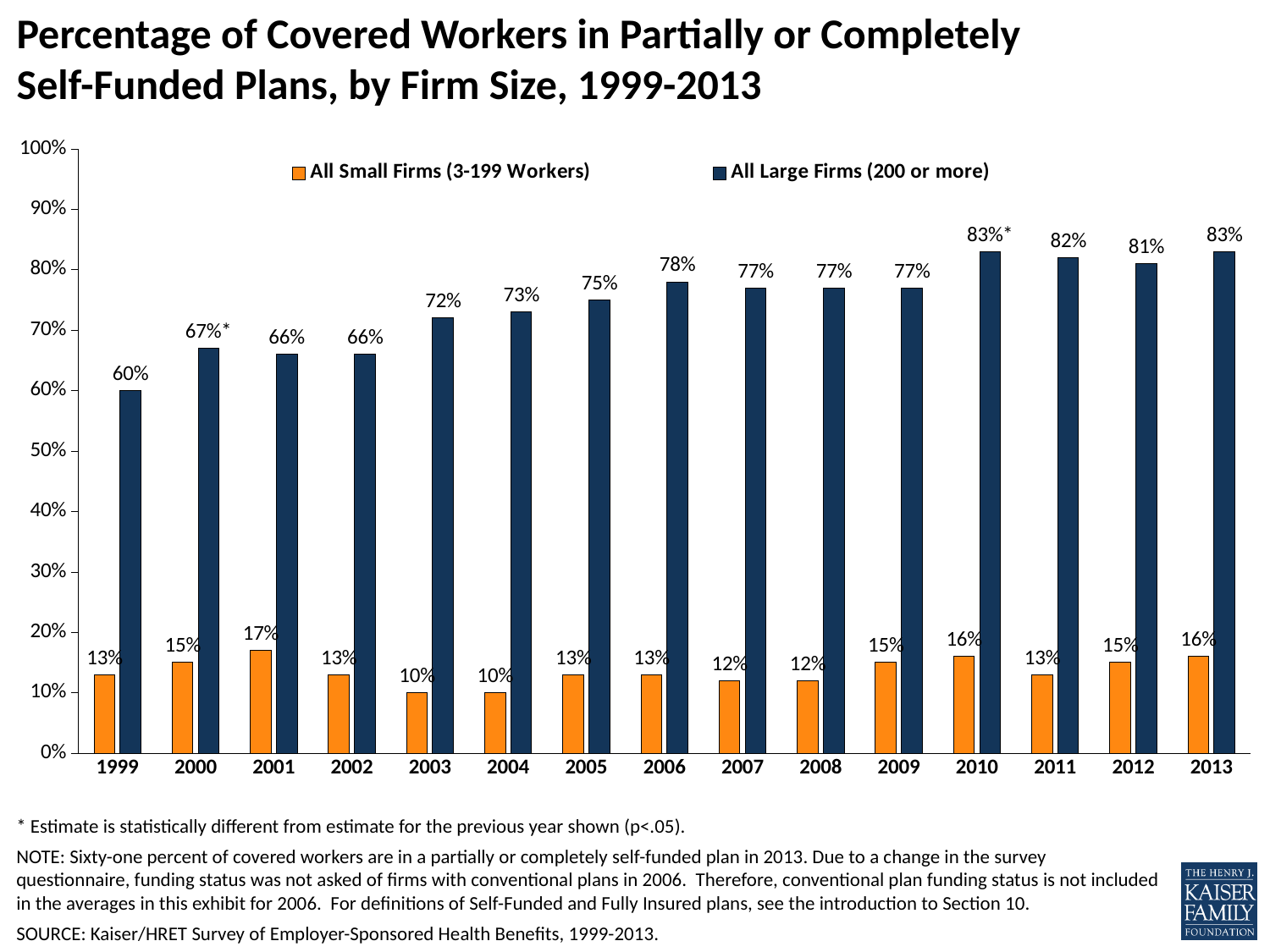
In which year is the value for All Large Firms (200 or more) lowest? 1999 By how many percentage points did the All Large Firms (200 or more) value change from 1999 to 2013? 23 percentage points How many series does the legend list? 2 What kind of chart is shown on the slide? Bar chart What is the value for All Small Firms (3-199 Workers) in 2013? 16% How many years are shown on the x axis? 15 Which is larger: the All Large Firms value in 2003 or in 2004? 2004 Is the value for All Large Firms (200 or more) in 2010 greater or less than 80%? greater What is the difference between the All Large Firms and All Small Firms values in 2013? 67 percentage points What percentage of covered workers at All Large Firms (200 or more) were in self-funded plans in 1999? 60% What is the value for All Large Firms (200 or more) in 2006? 78% In which year is the value for All Small Firms (3-199 Workers) highest? 2001